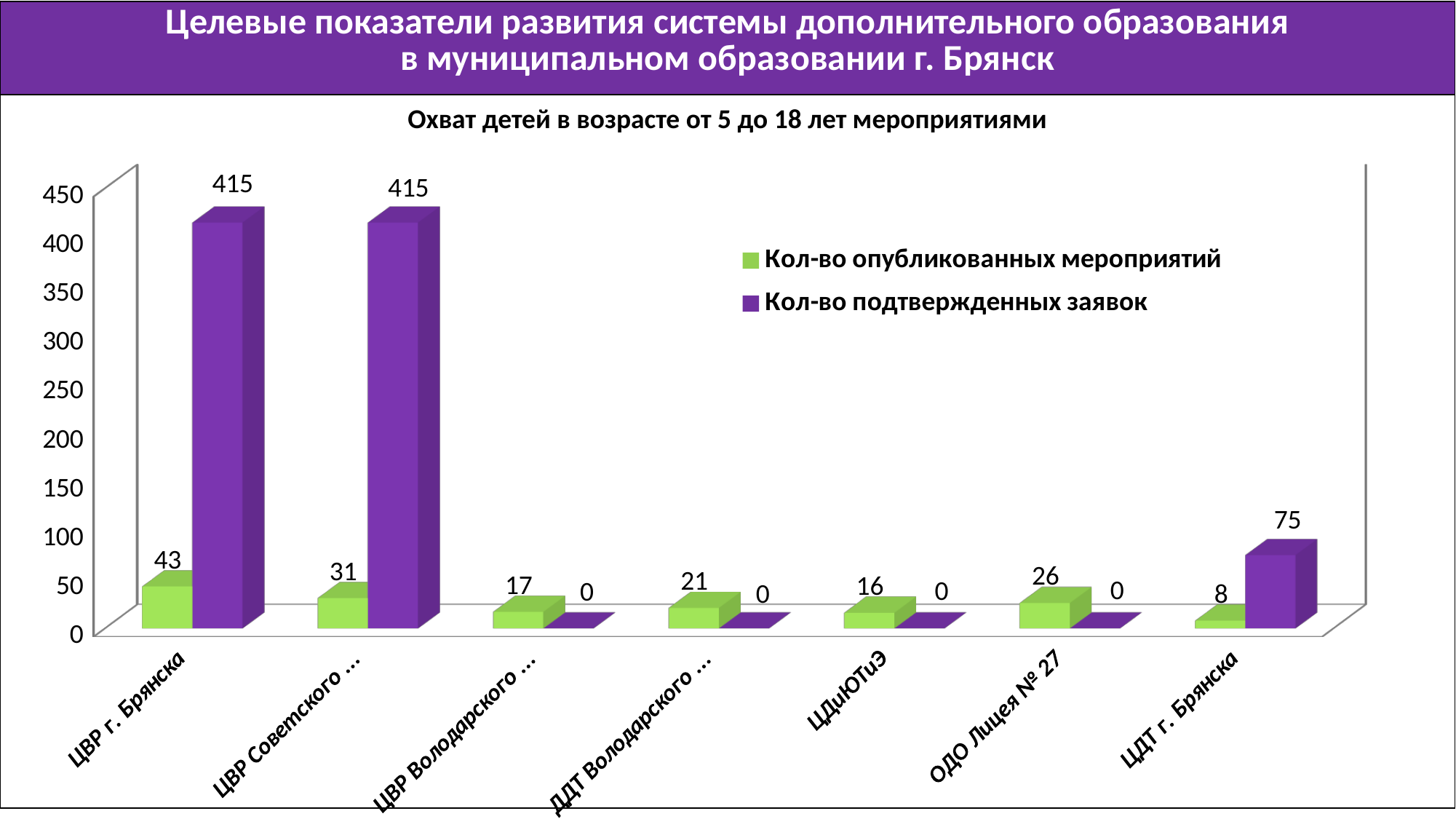
Which category has the highest value for "Кол-во опубликованных мероприятий"? ЦВР г. Брянска How many series does the chart legend list? 2 What is the value of "Кол-во опубликованных мероприятий" for ОДО Лицея № 27? 26 What is the value of "Кол-во подтвержденных заявок" for ЦДТ г. Брянска? 75 What is the value of "Кол-во подтвержденных заявок" for ЦДиЮТиЭ? 0 What type of chart is shown on the slide? Bar chart What is the value of "Кол-во опубликованных мероприятий" for ЦВР г. Брянска? 43 Which category has the lowest value for "Кол-во опубликованных мероприятий"? ЦДТ г. Брянска For ЦВР г. Брянска, what is the difference between "Кол-во подтвержденных заявок" and "Кол-во опубликованных мероприятий"? 372 Which has the larger value for "Кол-во опубликованных мероприятий": ОДО Лицея № 27 or ЦДиЮТиЭ? ОДО Лицея № 27 How many categories are shown on the x axis of the chart? 7 For ЦДТ г. Брянска, what is the difference between "Кол-во подтвержденных заявок" and "Кол-во опубликованных мероприятий"? 67